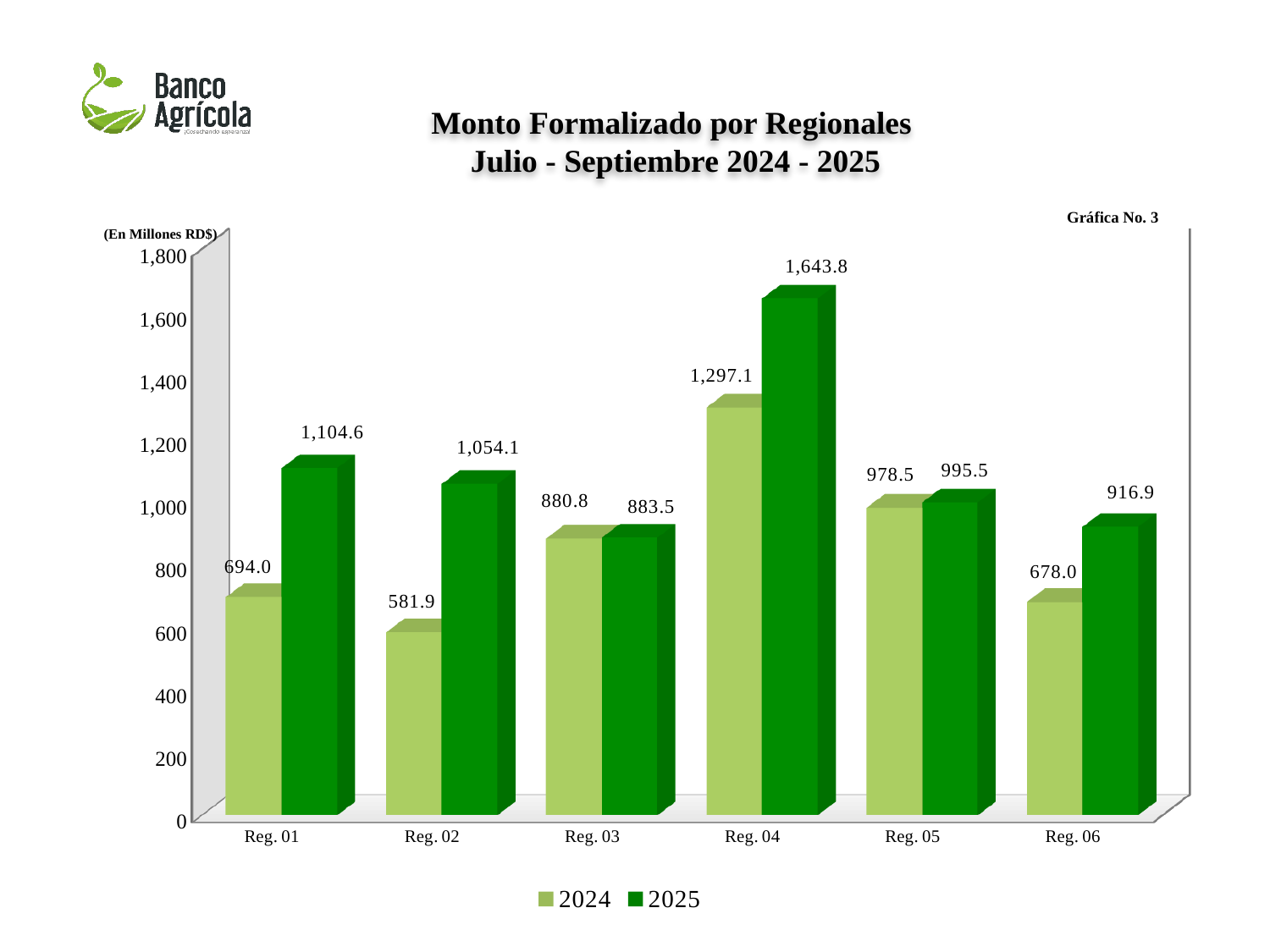
Which is larger for Reg. 02: the 2024 value or the 2025 value? 2025 Which region has the highest 2024 value? Reg. 04 What kind of chart is shown on the slide? Bar chart What is the difference between the 2025 and 2024 values for Reg. 01? 410.6 How many series does the legend list? 2 Which region has the lowest 2025 value? Reg. 03 How many regions are shown on the x axis? 6 What is the 2025 value for Reg. 04? 1,643.8 What is the 2025 value for Reg. 06? 916.9 What unit is stated for the values in the chart? En Millones RD$ What is the difference between the 2025 and 2024 values for Reg. 04? 346.7 What is the 2024 value for Reg. 02? 581.9